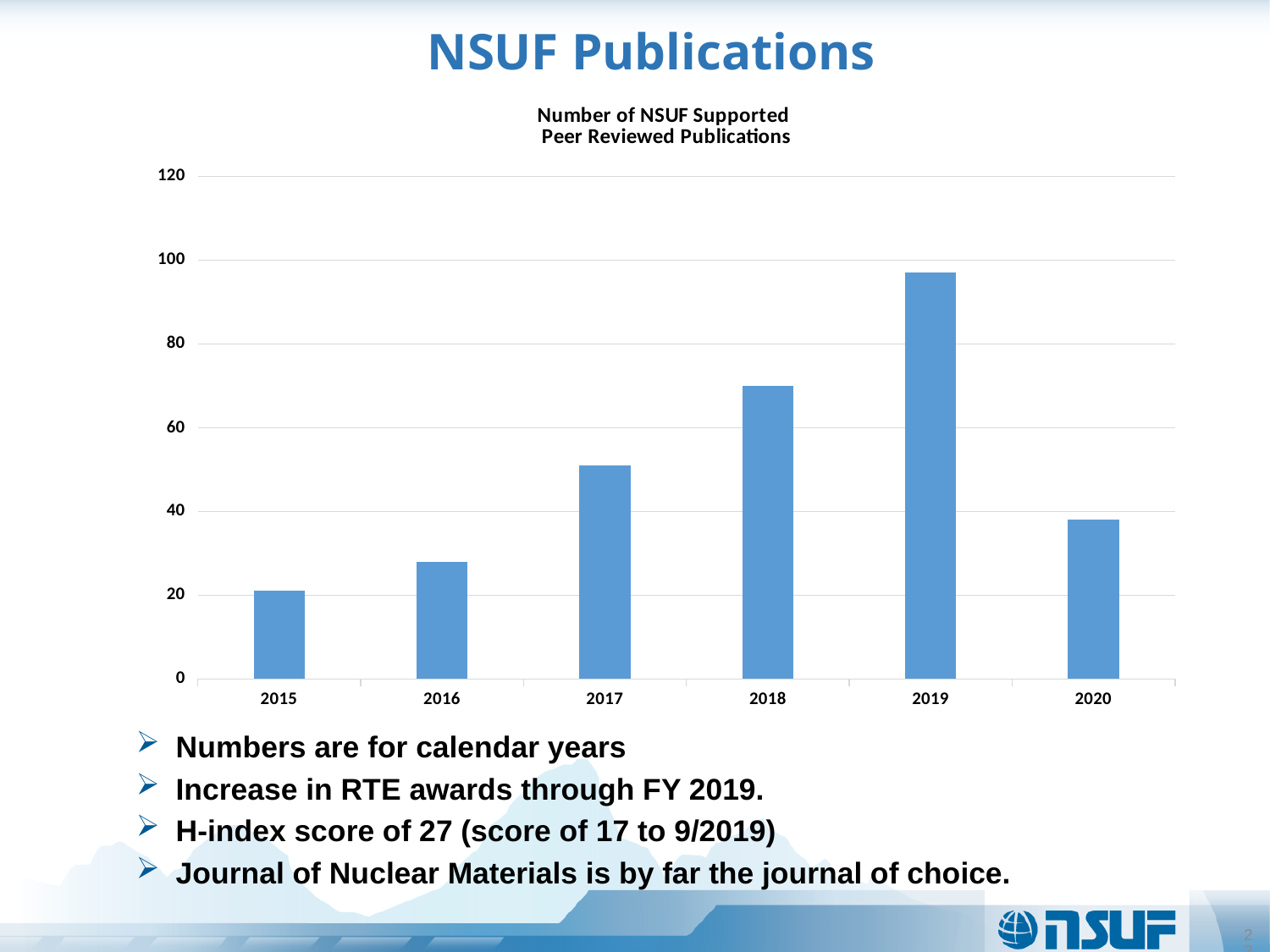
Which year has the highest number of publications? 2019 Which year has more publications, 2018 or 2020? 2018 Is the value for 2015 greater or less than 40? less Which year has the lowest number of publications? 2015 Is the value for 2020 greater or less than 20? greater Is the value for 2017 greater or less than 40? greater How many years are shown on the x axis of the chart? 6 What kind of chart is shown on the slide? bar chart What is the title of the chart? Number of NSUF Supported Peer Reviewed Publications Do the values rise or fall from 2015 to 2019? rise